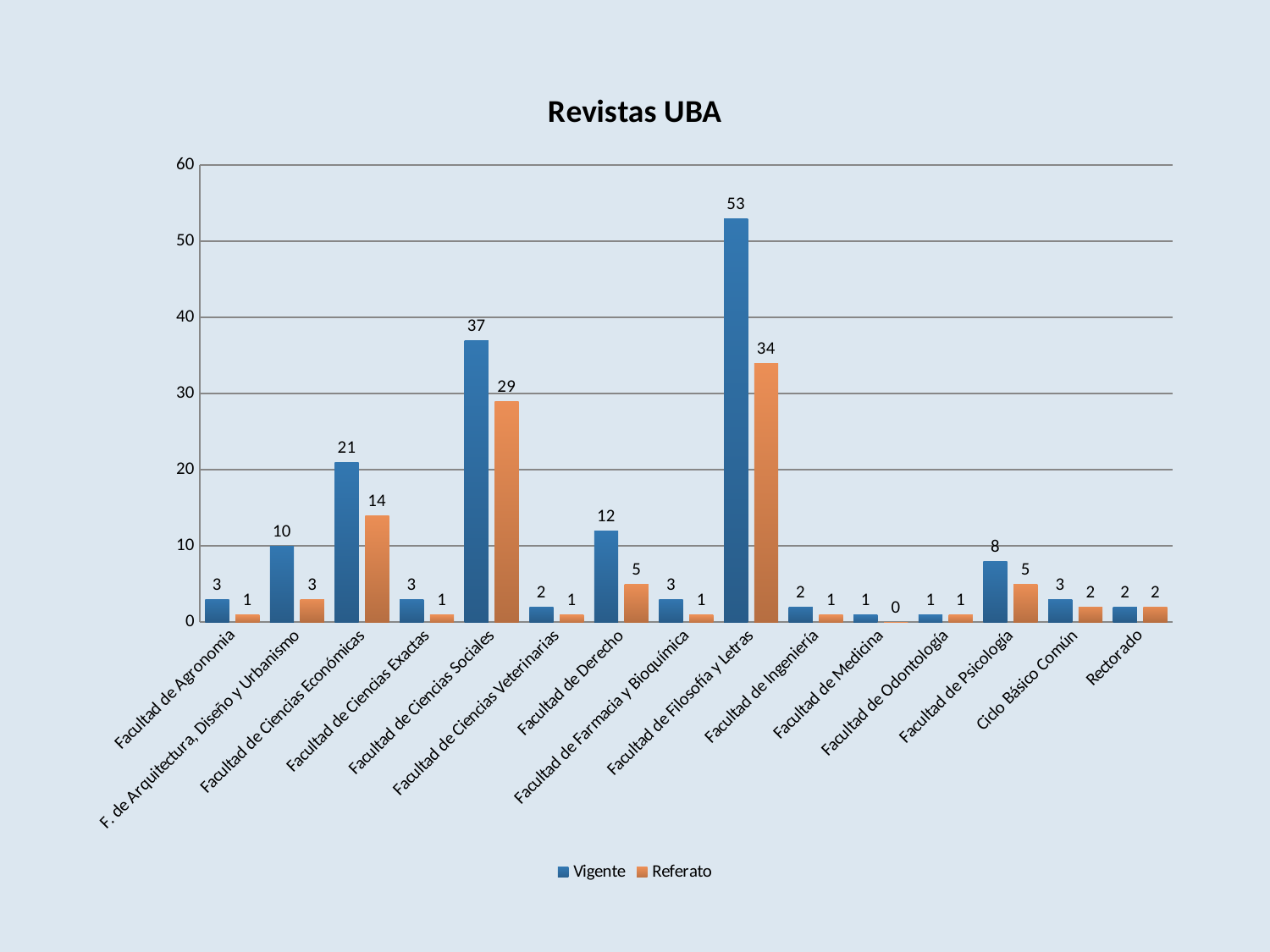
What is the title of the chart? Revistas UBA What is the Referato value for Facultad de Ciencias Sociales? 29 Which is larger, the Vigente value for Facultad de Derecho or the Vigente value for Facultad de Psicología? Facultad de Derecho How many categories are shown on the x axis? 15 How many series does the legend list? 2 What is the Referato value for Facultad de Ciencias Económicas? 14 What is the difference between the Vigente and Referato values for Facultad de Filosofía y Letras? 19 Which category has the highest Vigente value? Facultad de Filosofía y Letras Which category has the lowest Referato value? Facultad de Medicina Which series is shown in orange? Referato What is the Vigente value for Facultad de Filosofía y Letras? 53 What kind of chart is shown on the slide? Bar chart